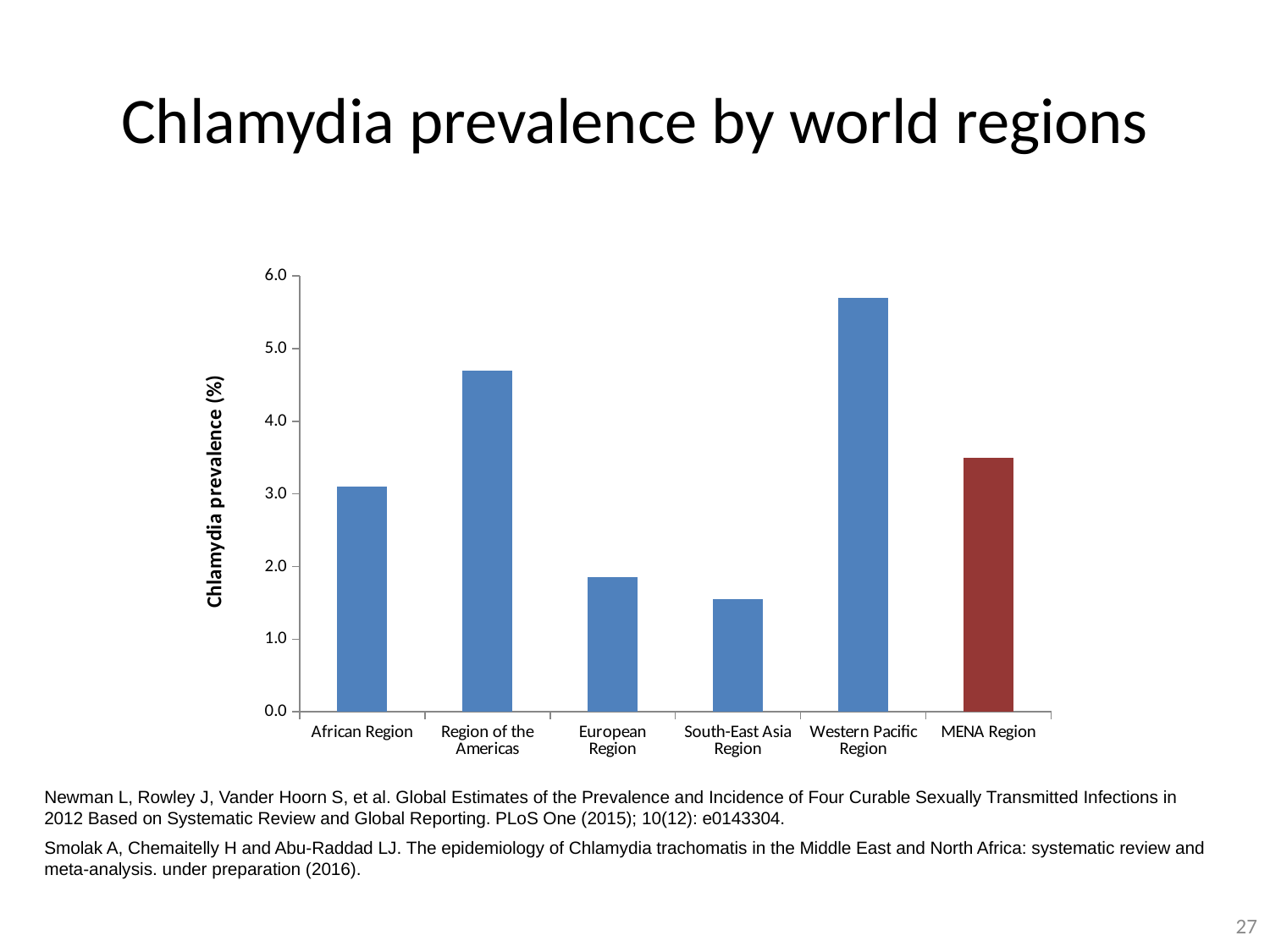
Is the chlamydia prevalence for the MENA Region greater or less than 4.0? less Is the chlamydia prevalence for the Region of the Americas greater or less than 4.0? greater Which has a higher chlamydia prevalence, the MENA Region or the African Region? MENA Region What kind of chart is shown on the slide? bar chart Which region has the highest chlamydia prevalence? Western Pacific Region Is the chlamydia prevalence for the African Region greater or less than 4.0? less Which region has the lowest chlamydia prevalence? South-East Asia Region Which has a higher chlamydia prevalence, the Western Pacific Region or the Region of the Americas? Western Pacific Region Which bar is shown in a different colour (red) from the others? MENA Region How many regions are plotted in the chart? 6